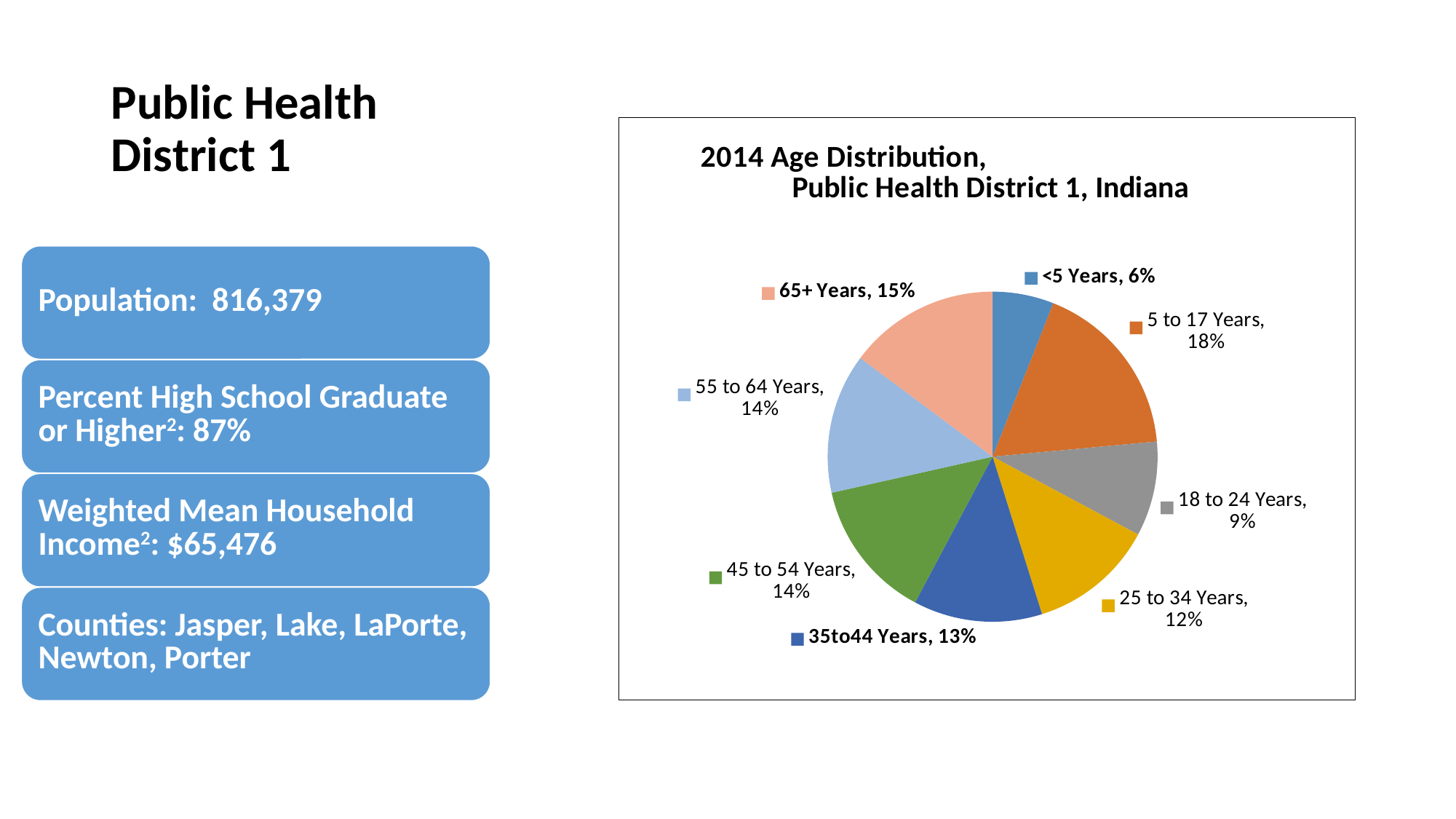
What is the value for the 65+ Years slice? 15% What is the title of the chart? 2014 Age Distribution, Public Health District 1, Indiana What is the value for the 18 to 24 Years slice? 9% What colour is the 45 to 54 Years slice? green What share of the pie does the <5 Years slice represent? 6% What type of chart is shown on the slide? pie chart Which age group has the smallest share of the pie? <5 Years Which age group has the largest share of the pie? 5 to 17 Years How many age groups are shown in the pie chart? 8 What percentage of the population is in the 5 to 17 Years group? 18% Which is larger, the 25 to 34 Years slice or the 35to44 Years slice? 35to44 Years What is the difference in percentage points between the 5 to 17 Years slice and the 18 to 24 Years slice? 9